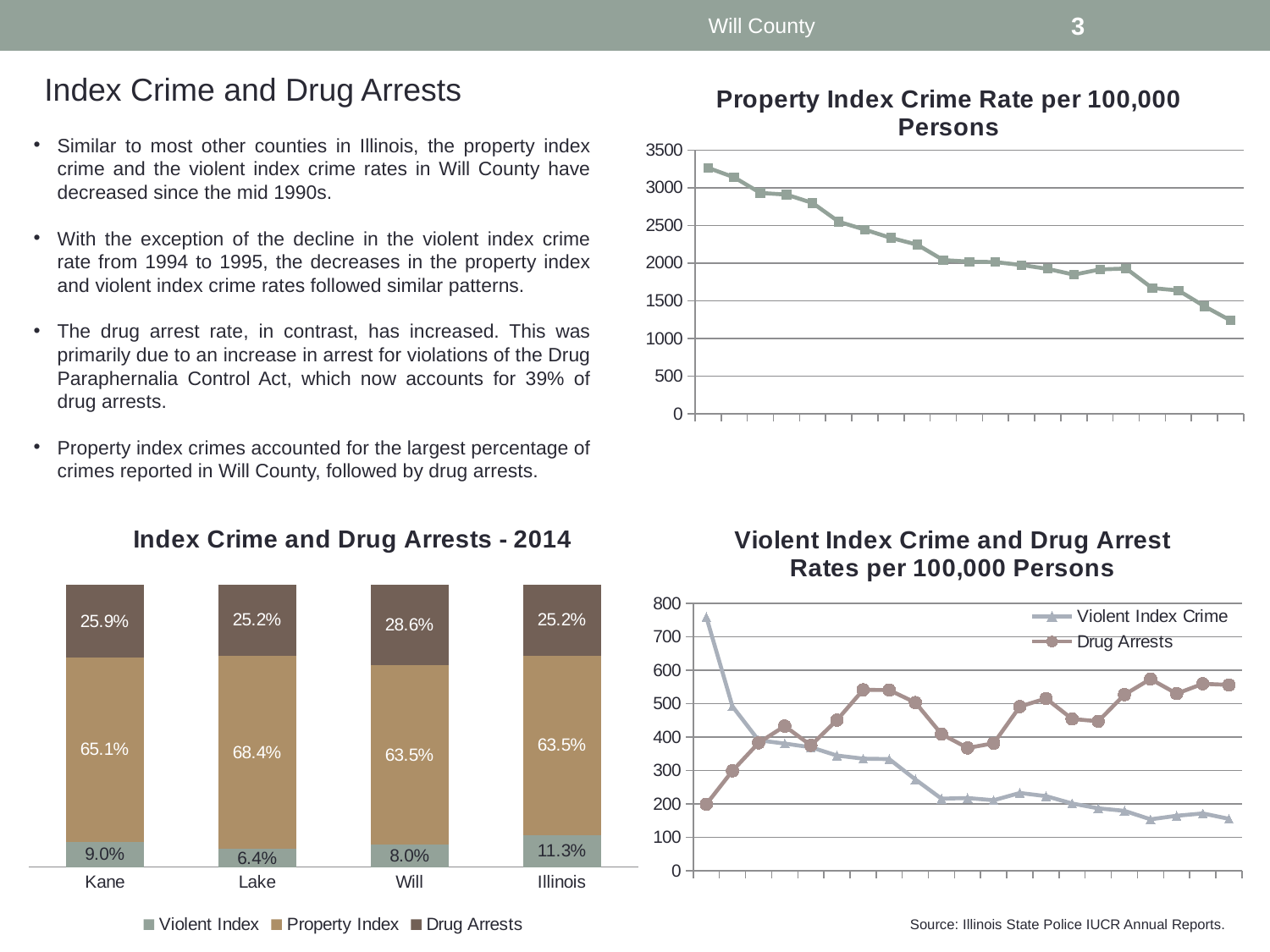
In the 'Index Crime and Drug Arrests - 2014' chart, what is the Drug Arrests percentage for Will? 28.6% In the 'Index Crime and Drug Arrests - 2014' chart, what is the Property Index percentage for Lake? 68.4% How many series does the legend of the 'Violent Index Crime and Drug Arrest Rates per 100,000 Persons' chart list? 2 In the 'Index Crime and Drug Arrests - 2014' chart, which category has the lowest Violent Index percentage? Lake In the 'Property Index Crime Rate per 100,000 Persons' chart, is the first plotted value greater or less than 3000? greater In the 'Index Crime and Drug Arrests - 2014' chart, which category has the highest Violent Index percentage? Illinois In the 'Index Crime and Drug Arrests - 2014' chart, what is the difference between the Drug Arrests percentage for Will and for Kane? 2.7 percentage points In the 'Property Index Crime Rate per 100,000 Persons' chart, do the values generally rise or fall along the x axis? Fall How many series does the legend of the 'Index Crime and Drug Arrests - 2014' chart list? 3 In the 'Index Crime and Drug Arrests - 2014' chart, which has a larger Property Index percentage, Kane or Lake? Lake What kind of chart is 'Index Crime and Drug Arrests - 2014'? Stacked bar chart How many categories are shown on the x axis of the 'Index Crime and Drug Arrests - 2014' chart? 4